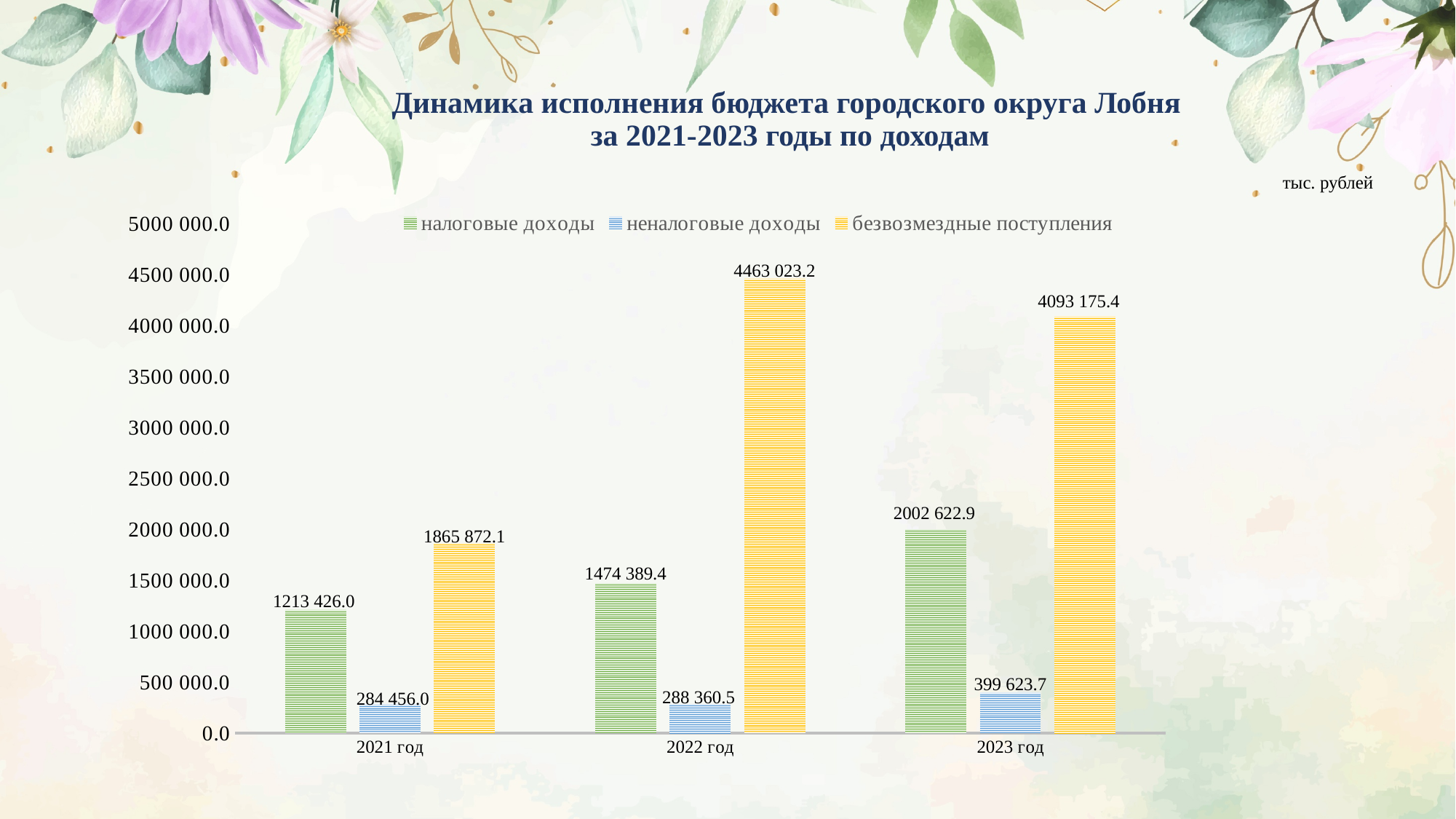
What kind of chart is shown on the slide? bar chart Do the values of налоговые доходы rise or fall from 2021 год to 2023 год? rise Which is larger: налоговые доходы in 2023 год or безвозмездные поступления in 2021 год? налоговые доходы in 2023 год Is the value of безвозмездные поступления for 2023 год greater or less than 4000 000.0? greater What is the value of безвозмездные поступления for 2022 год? 4463 023.2 What is the difference between налоговые доходы in 2023 год and in 2022 год? 528 233.5 What is the value of неналоговые доходы for 2023 год? 399 623.7 What is the difference between безвозмездные поступления in 2022 год and in 2023 год? 369 847.8 In which year is безвозмездные поступления the highest? 2022 год How many series does the legend list? 3 In which year is неналоговые доходы the lowest? 2021 год What is the value of налоговые доходы for 2021 год? 1213 426.0